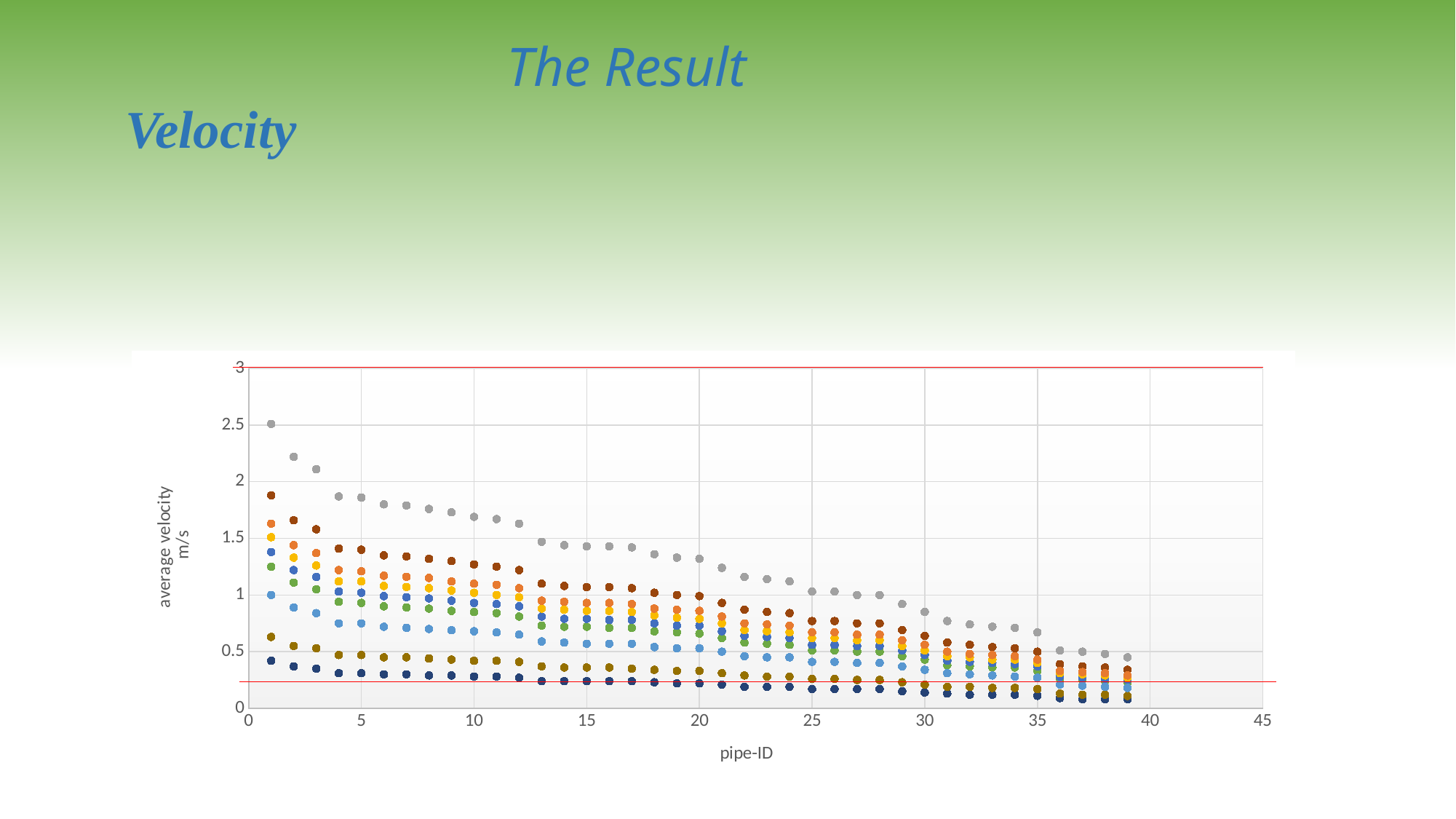
Is the highest plotted value at pipe-ID 39 greater or less than 1? less Are any plotted points above 3 on the y axis? no Is the lowest plotted value at pipe-ID 1 greater or less than 1? less Do the plotted velocity values generally rise or fall as pipe-ID increases? fall What is the title of the x axis of the chart? pipe-ID What quantity does the y axis of the chart measure, according to its axis title? average velocity m/s What kind of chart is shown on the slide? scatter chart What is the largest value labelled on the y axis? 3